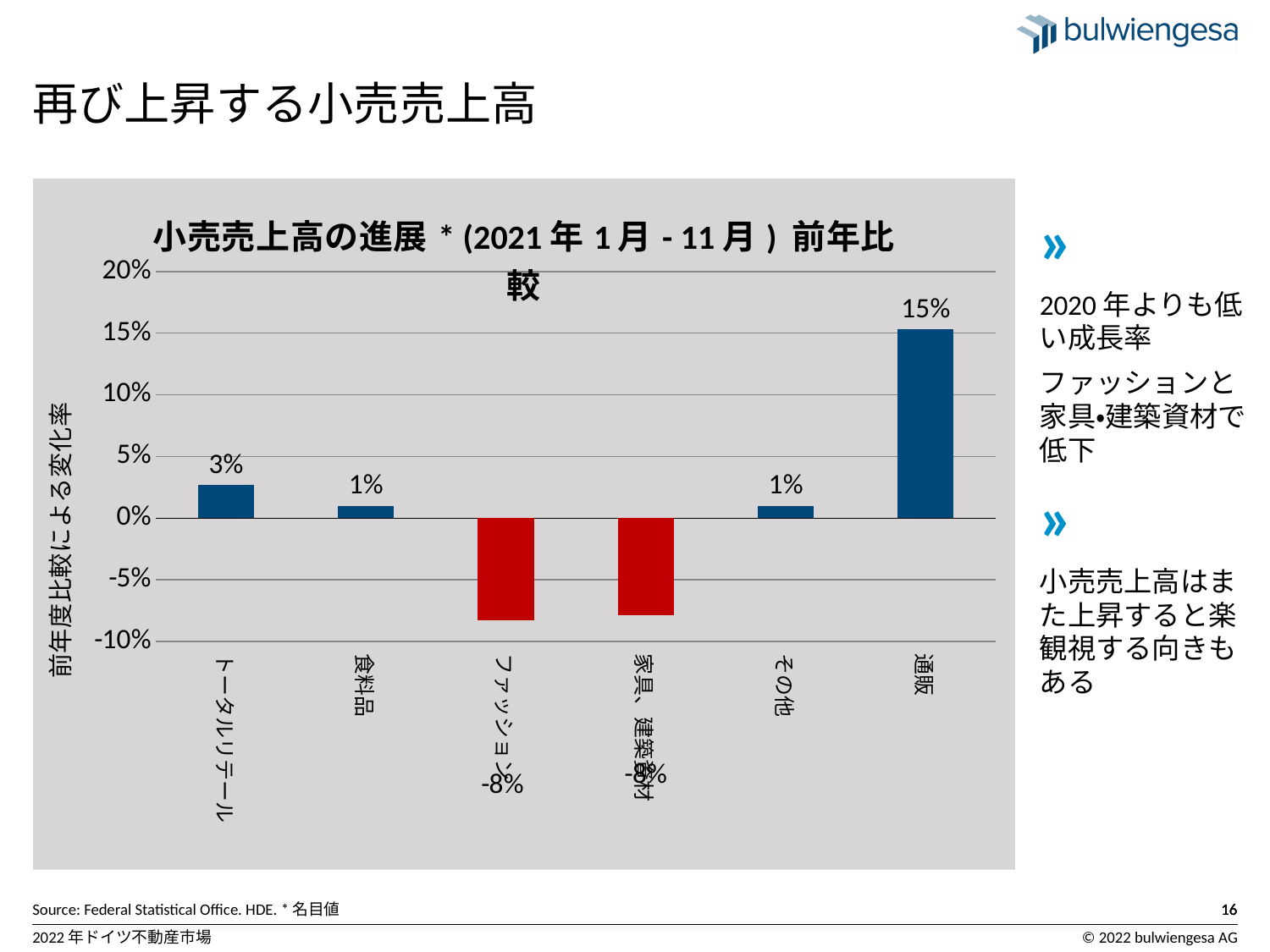
What is the value for その他 in the chart? 1% What is the value for 通販 in the chart? 15% Which is larger, the value for 通販 or the value for 食料品? 通販 What is the value for トータルリテール in the chart? 3% What is the value for ファッション in the chart? -8% How many categories are shown in the chart? 6 Which category has the highest value in the chart? 通販 What kind of chart is shown on the slide? bar chart Is the value for 家具、建築資材 greater or less than -5%? less What is the value for 食料品 in the chart? 1% What is the difference between the values for 通販 and トータルリテール? 12 percentage points What is the label of the vertical axis of the chart? 前年度比較による変化率